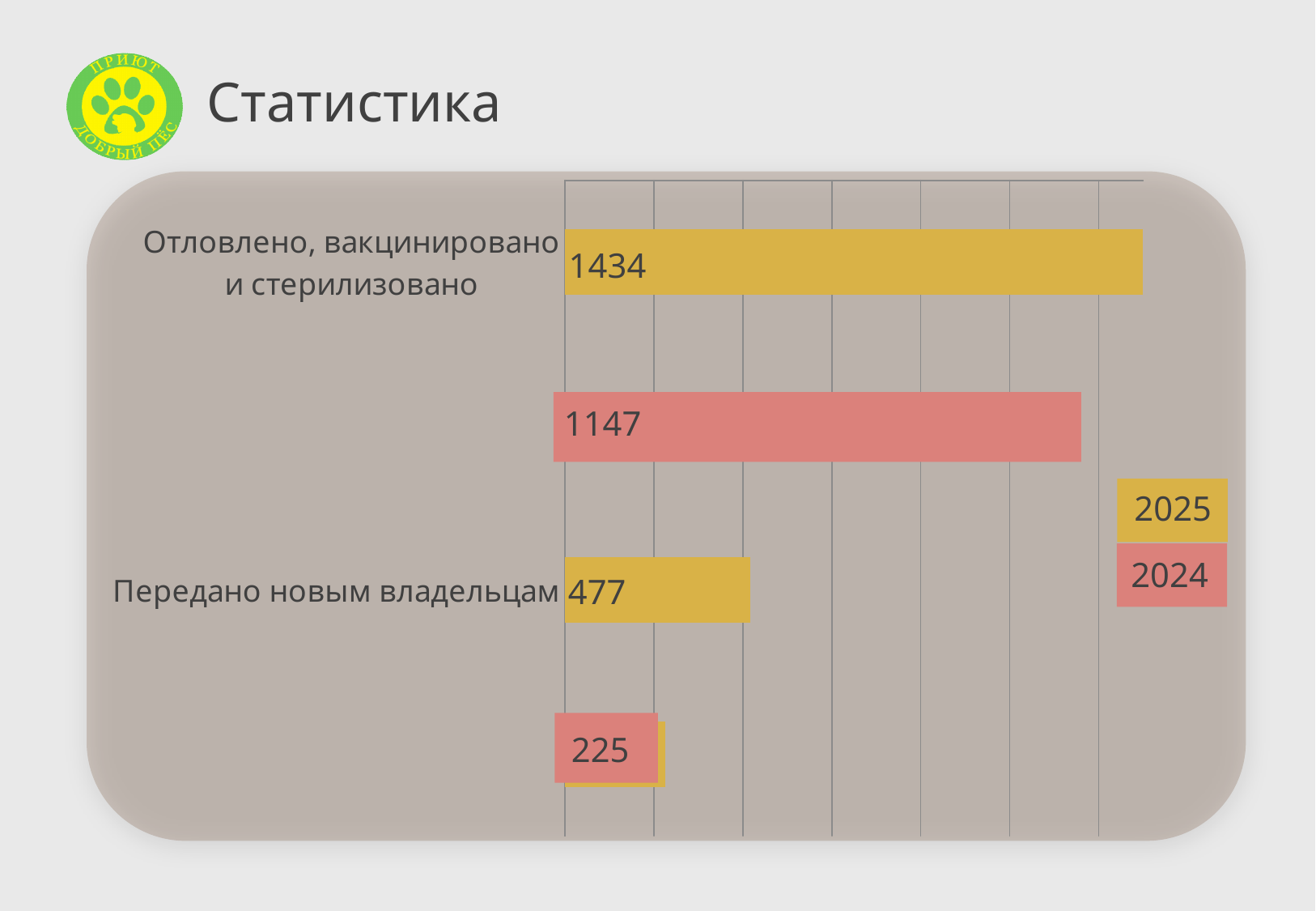
What is the 2024 value for "Отловлено, вакцинировано и стерилизовано"? 1147 Which is larger for "Передано новым владельцам": the 2025 value or the 2024 value? 2025 What is the 2025 value for "Отловлено, вакцинировано и стерилизовано"? 1434 What is the difference between the 2025 and 2024 values for "Отловлено, вакцинировано и стерилизовано"? 287 How many series does the legend list? 2 Which colour represents the 2024 series in the legend? Red Which bar has the highest value on the chart? Отловлено, вакцинировано и стерилизовано (2025) What is the 2024 value for "Передано новым владельцам"? 225 How many categories are shown on the chart? 2 What is the difference between the 2025 and 2024 values for "Передано новым владельцам"? 252 What is the 2025 value for "Передано новым владельцам"? 477 What type of chart is shown on the slide? Bar chart